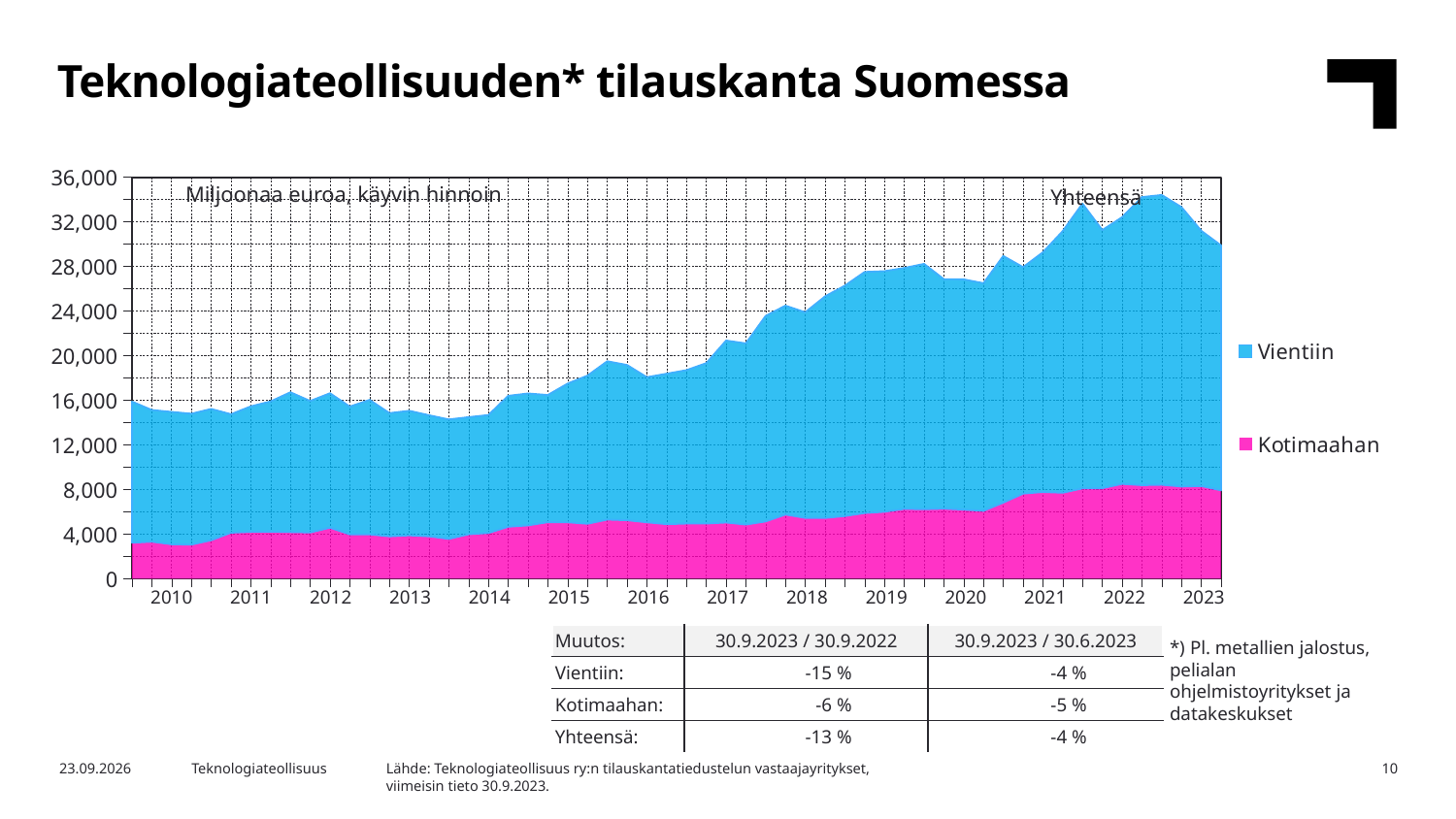
Is the total (Yhteensä) value at the end of 2023 greater or less than 28,000? greater What kind of chart is shown on the slide? Stacked area chart How many year labels are shown on the x axis? 14 Is the total (Yhteensä) value in 2013 greater or less than 16,000? less Does the total order book (Yhteensä) rise or fall overall from 2010 to 2023? Rise In which year does the total (Yhteensä) reach its highest level? 2022 How many series does the chart legend list? 2 Which series is larger throughout the period, Vientiin or Kotimaahan? Vientiin Which two series are listed in the chart legend? Vientiin and Kotimaahan What unit is stated in the label inside the chart area? Miljoonaa euroa, käyvin hinnoin Is the peak total (Yhteensä) value in 2022 greater or less than 32,000? greater